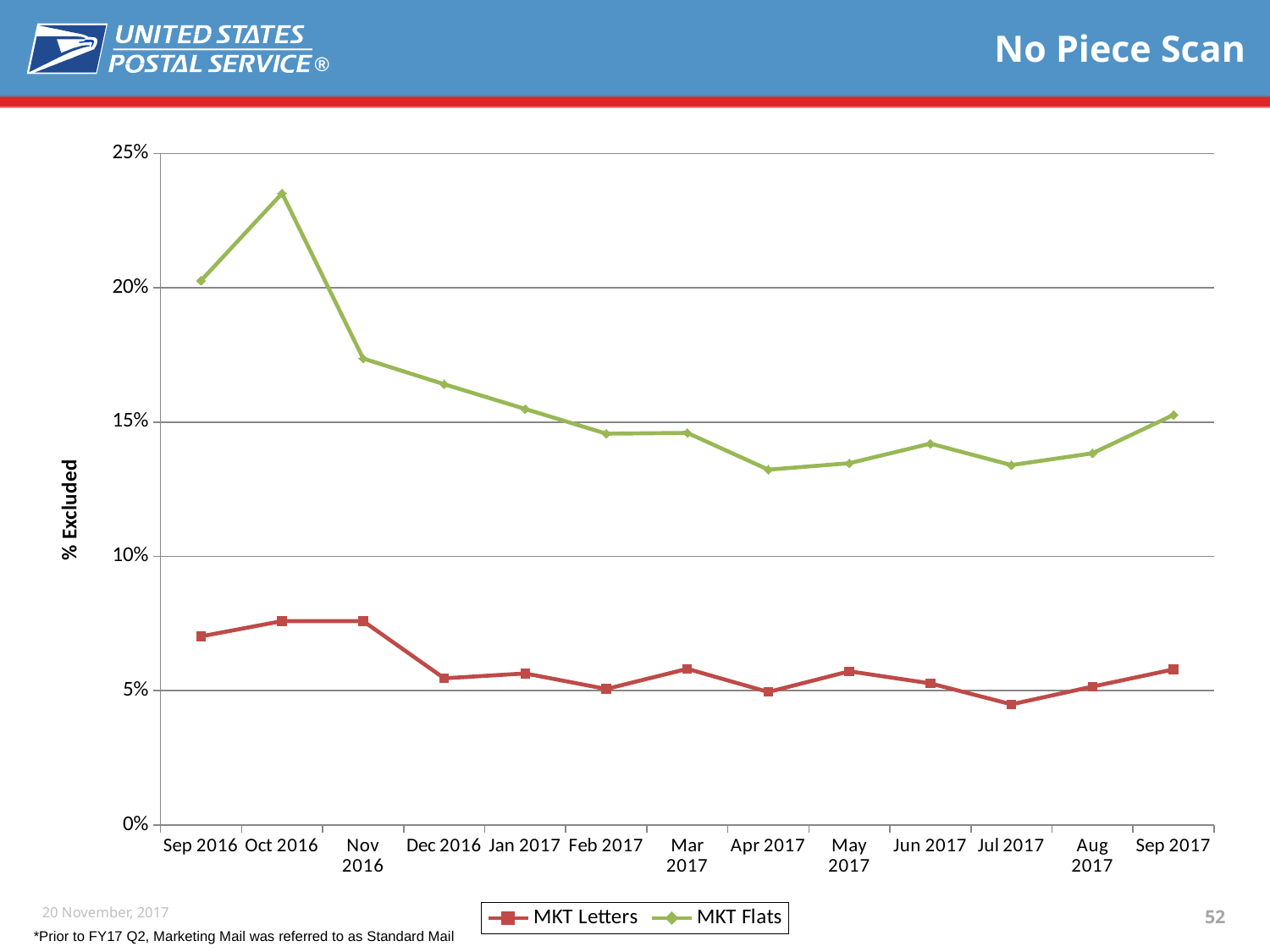
Does the MKT Flats series rise or fall from Oct 2016 to Apr 2017? fall Is the value for MKT Flats in Oct 2016 greater or less than 20%? greater In which month does the MKT Letters series reach its lowest value? Jul 2017 What is the label on the y axis? % Excluded In which month does the MKT Flats series reach its highest value? Oct 2016 Is the value for MKT Letters in Oct 2016 greater or less than 10%? less Is the value for MKT Letters in Jul 2017 greater or less than 5%? less Which series has the higher value in Sep 2017, MKT Letters or MKT Flats? MKT Flats What kind of chart is shown on the slide? line chart How many months are plotted along the x axis? 13 How many series does the legend list? 2